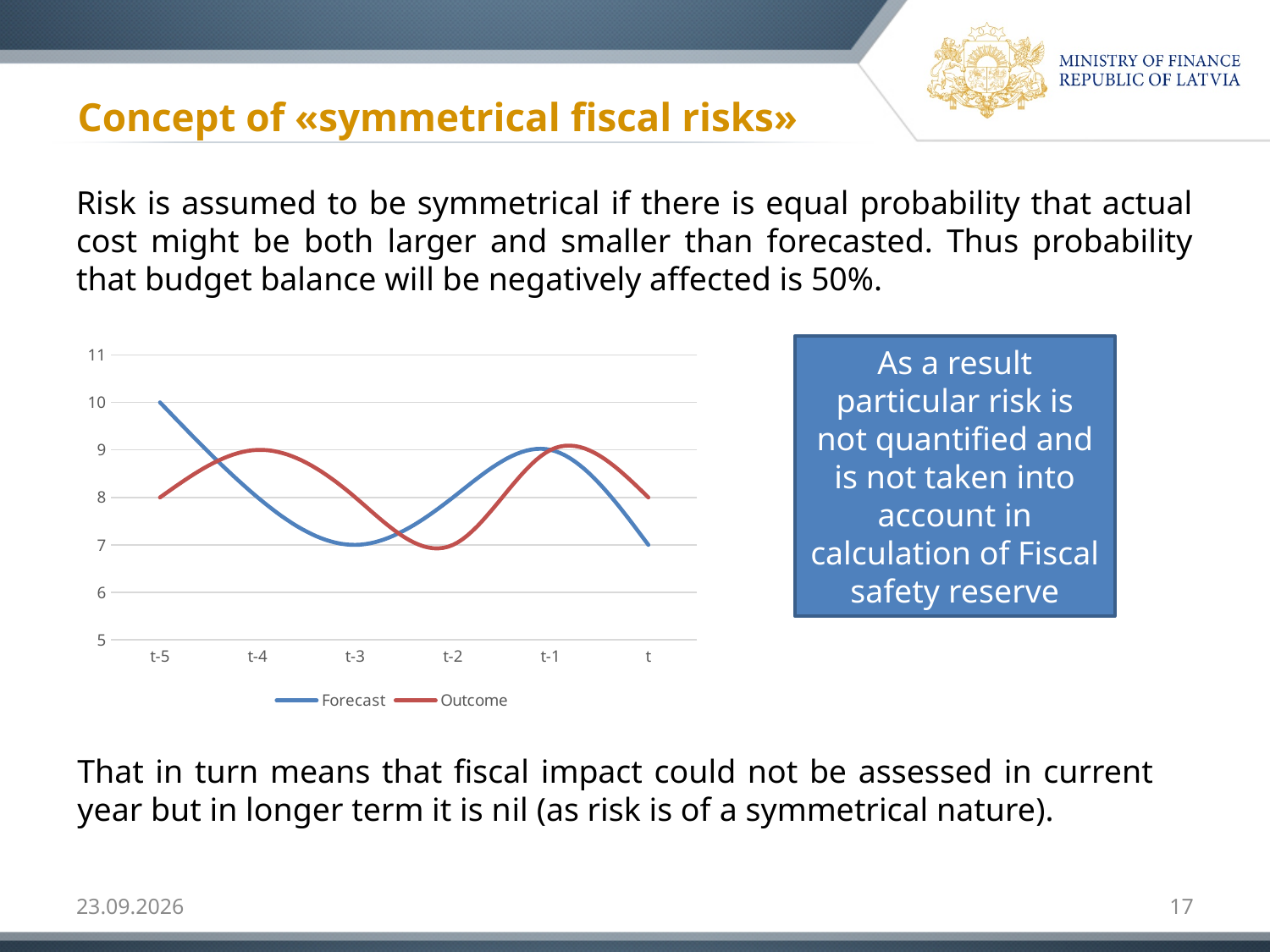
At which x-axis point is the Outcome series lowest? t-2 How many series does the chart legend list? 2 What is the Forecast value at t-5? 10 How many points are on the x axis of the chart? 6 What is the difference between the Forecast and Outcome values at t-5? 2 What is the Forecast value at t? 7 Which series is drawn in red in the chart? Outcome Which series has the larger value at t-4, Forecast or Outcome? Outcome What kind of chart is shown on the slide? line chart At which x-axis point is the Forecast series highest? t-5 Which series has the larger value at t-5, Forecast or Outcome? Forecast What is the Outcome value at t-5? 8